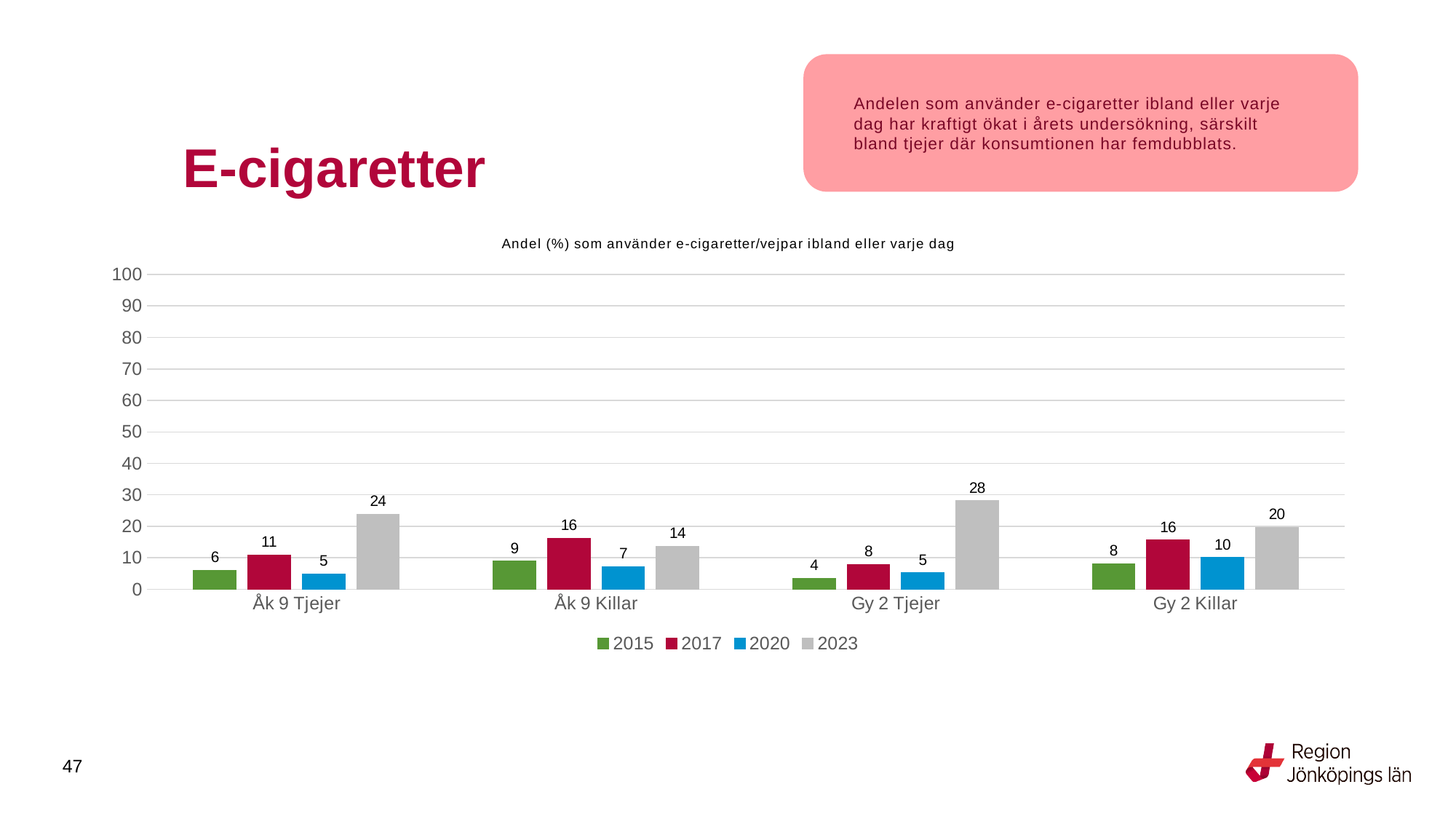
What is the value for Gy 2 Tjejer in 2015? 4 Is the value for Gy 2 Tjejer in 2023 greater or less than 20? greater Which is larger for Åk 9 Killar: the 2017 value or the 2023 value? 2017 What is the value for Åk 9 Tjejer in 2023? 24 Which category has the highest value in 2023? Gy 2 Tjejer What is the title of the chart? Andel (%) som använder e-cigaretter/vejpar ibland eller varje dag What is the value for Gy 2 Killar in 2020? 10 How many categories are shown on the x axis? 4 How many series does the legend list? 4 Which category has the lowest value in 2015? Gy 2 Tjejer What kind of chart is shown on the slide? bar chart What is the difference between the 2023 and 2020 values for Gy 2 Tjejer? 23